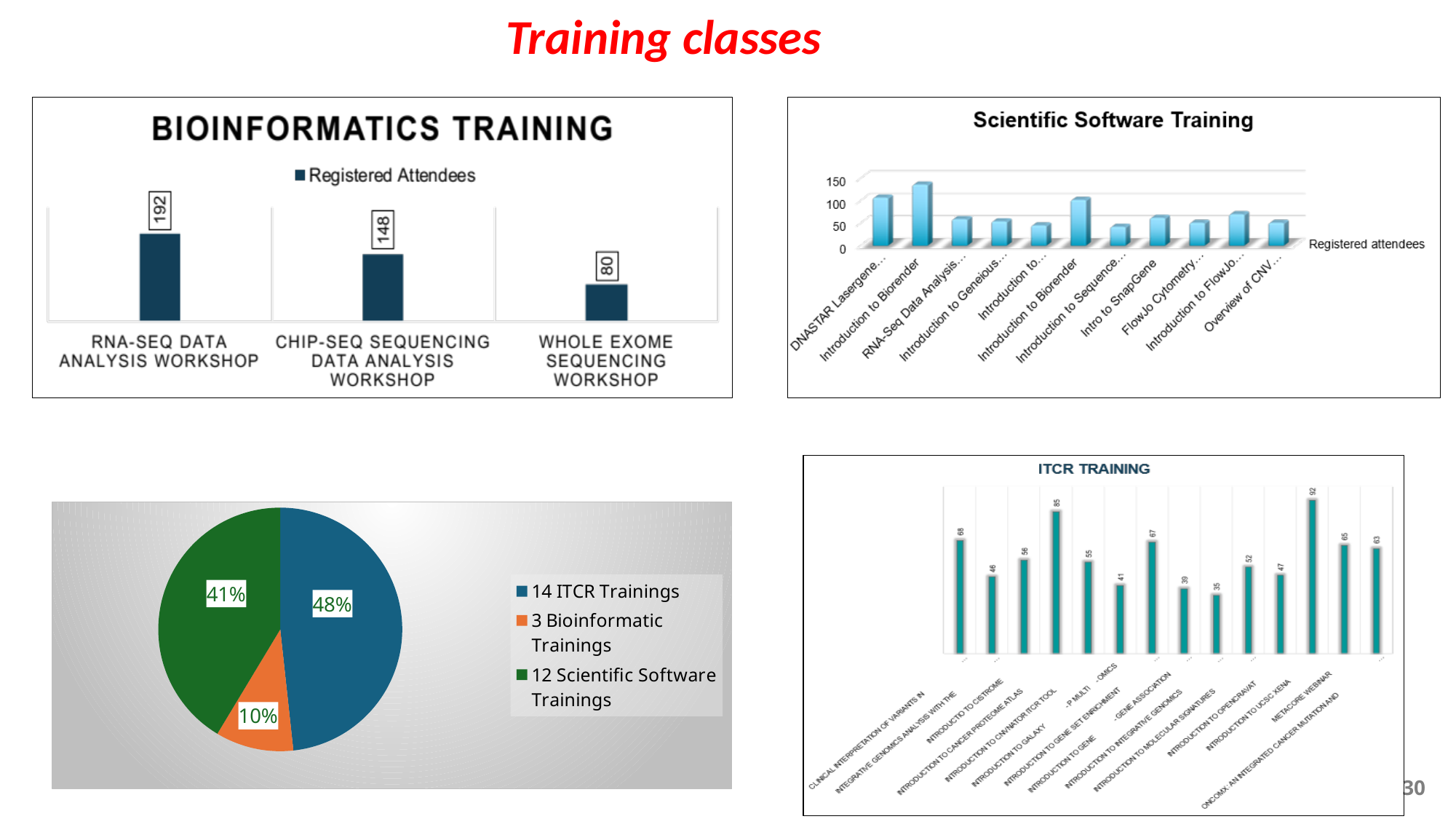
In the BIOINFORMATICS TRAINING chart, what is the difference in registered attendees between the RNA-SEQ DATA ANALYSIS WORKSHOP and the CHIP-SEQ SEQUENCING DATA ANALYSIS WORKSHOP? 44 What kind of chart is the Scientific Software Training chart? bar chart In the ITCR TRAINING chart, what is the highest value shown on a bar? 92 In the BIOINFORMATICS TRAINING chart, which workshop had the fewest registered attendees? WHOLE EXOME SEQUENCING WORKSHOP In the BIOINFORMATICS TRAINING chart, how many registered attendees did the WHOLE EXOME SEQUENCING WORKSHOP have? 80 In the Scientific Software Training chart, how many bars are plotted? 11 In the Scientific Software Training chart, is the value for Intro to SnapGene greater or less than 100? less In the pie chart at the bottom left, what share is shown for 14 ITCR Trainings? 48% In the BIOINFORMATICS TRAINING chart, how many registered attendees did the RNA-SEQ DATA ANALYSIS WORKSHOP have? 192 In the BIOINFORMATICS TRAINING chart, how many workshops are shown? 3 In the ITCR TRAINING chart, how many bars are plotted? 14 In the pie chart at the bottom left, which legend entry has the smallest slice? 3 Bioinformatic Trainings